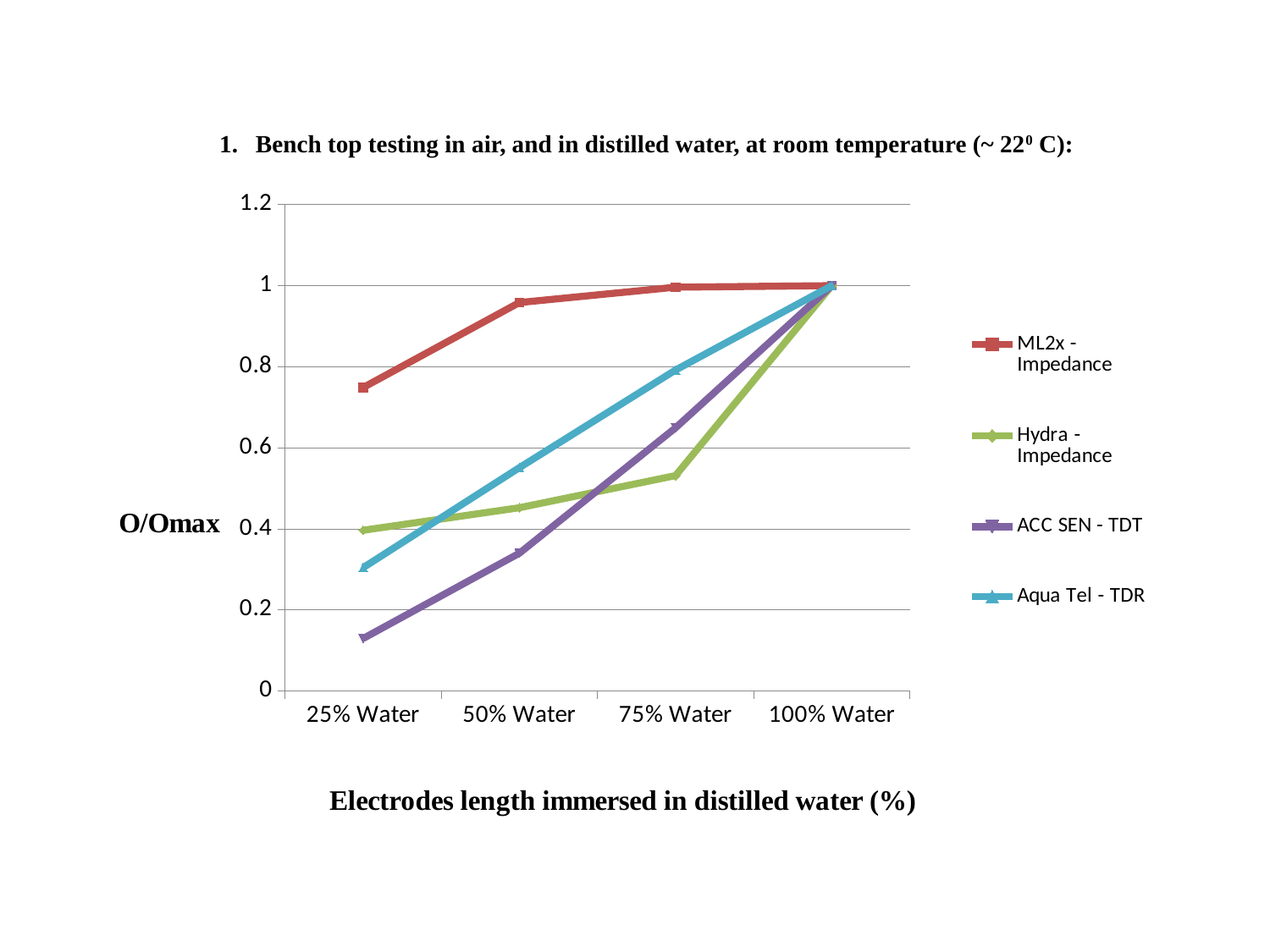
What kind of chart is shown on the slide? line chart Which series has the lowest value at 25% Water? ACC SEN - TDT Is the value for Hydra - Impedance at 50% Water greater or less than 0.4? greater Does the ACC SEN - TDT series rise or fall from 25% Water to 100% Water? rise At 75% Water, which is larger: Aqua Tel - TDR or Hydra - Impedance? Aqua Tel - TDR How many series does the legend list? 4 What is the O/Omax value for ML2x - Impedance at 100% Water? 1 Is the value for ML2x - Impedance at 50% Water greater or less than 0.8? greater How many categories are shown on the x axis? 4 Is the value for ACC SEN - TDT at 25% Water greater or less than 0.2? less What is the label on the y axis? O/Omax Which series has the highest value at 25% Water? ML2x - Impedance